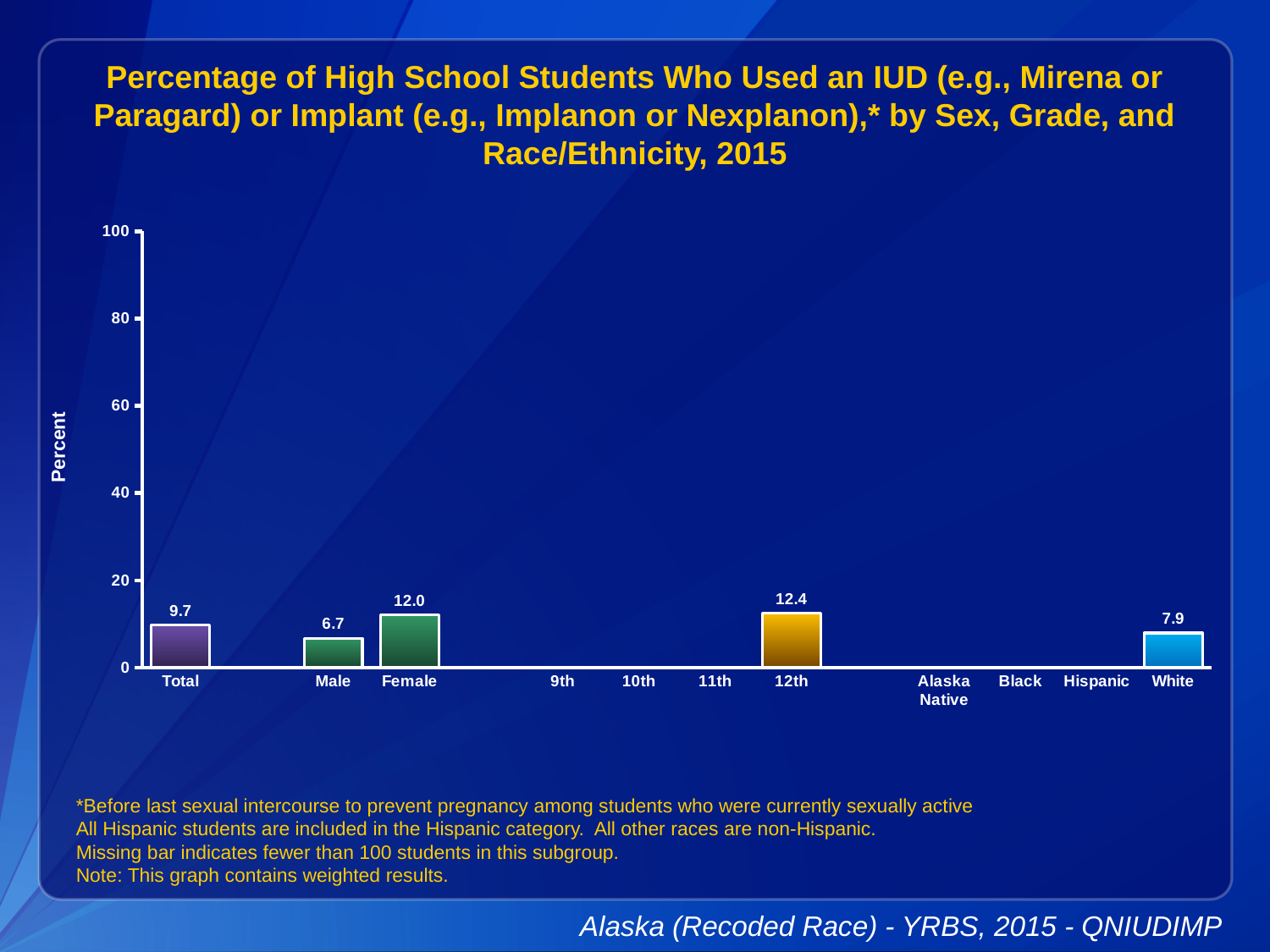
Which category has the highest value? 12th Which category with a plotted bar has the lowest value? Male What is the value for Total? 9.7 How many categories have a plotted bar? 5 Which is larger, the value for Total or the value for White? Total What is the label on the y axis? Percent What is the difference between the Female and Male values? 5.3 Is the value for 12th grade greater or less than 20? less What is the value for White? 7.9 What is the value for 12th grade? 12.4 What kind of chart is this? bar chart What is the value for Female? 12.0